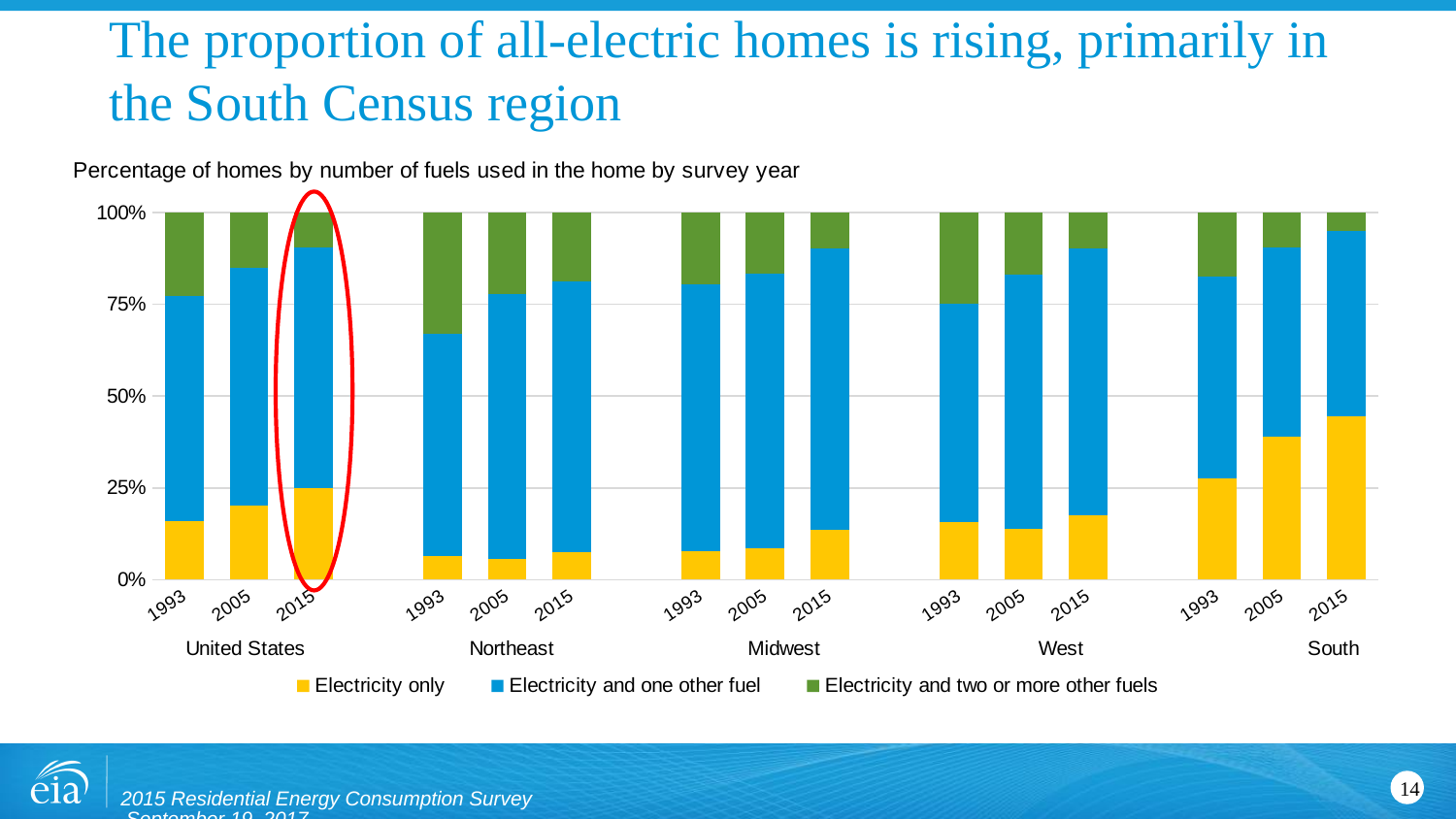
How many series does the legend list? 3 Does the 'Electricity only' share for the United States rise or fall from 1993 to 2015? rise Is the 'Electricity only' value for Northeast in 1993 greater or less than 25%? less Which region has the highest 'Electricity only' share in 2015? South How many bars are plotted in total on the chart? 15 Which is larger: the 'Electricity only' share for South in 2015 or for Midwest in 2015? South in 2015 How many Census regions (including United States) are shown along the x axis? 5 Is the 'Electricity only' value for South in 2005 greater or less than 25%? greater Which legend entry is shown in green? Electricity and two or more other fuels Is the 'Electricity only' value for South in 2015 greater or less than 50%? less Which region has the lowest 'Electricity only' share in 2015? Northeast What kind of chart is shown on the slide? Stacked bar chart